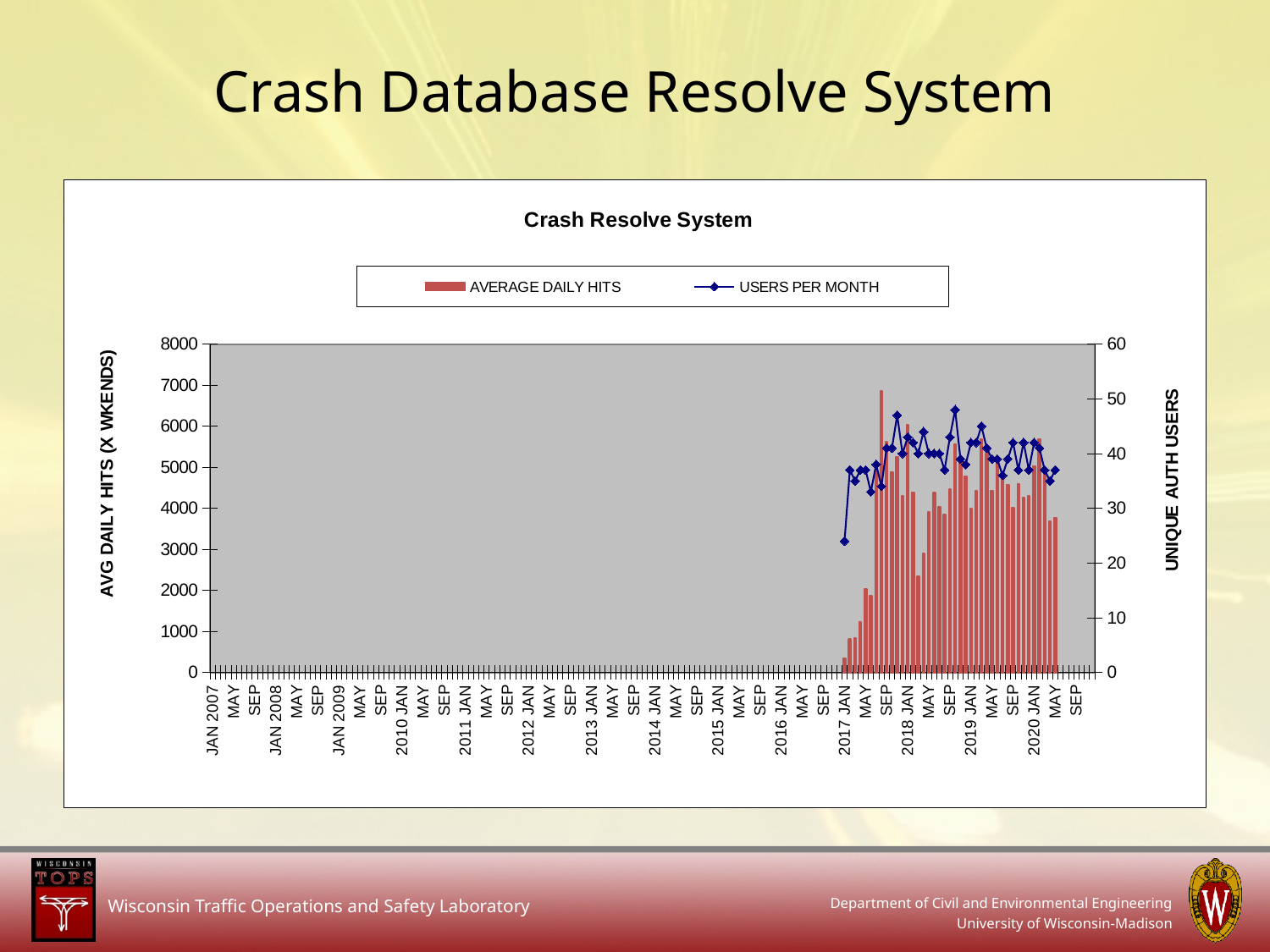
What kind of chart is this? Combined bar and line chart What is the title of the chart? Crash Resolve System How many series does the chart legend list? 2 What is the highest value shown on the left vertical axis? 8000 Is the tallest AVERAGE DAILY HITS bar greater or less than 6000? greater Is the USERS PER MONTH value at JAN 2017 greater or less than 30? less What is the label of the left vertical axis? AVG DAILY HITS (X WKENDS) Which series is drawn as bars? AVERAGE DAILY HITS What is the highest value shown on the right vertical axis? 60 What is the label of the right vertical axis? UNIQUE AUTH USERS What is the first month label on the x axis? JAN 2007